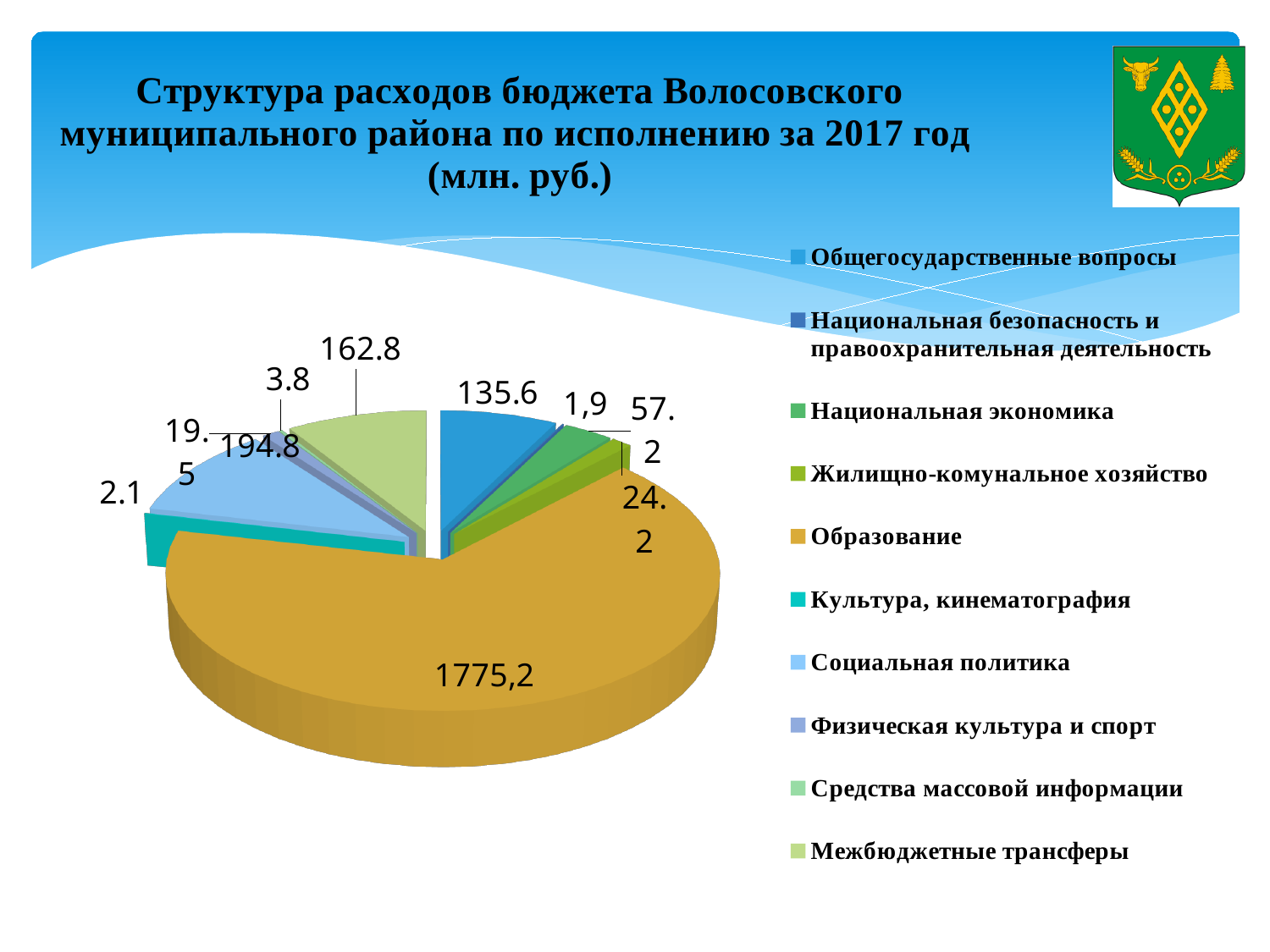
What is the value shown for Образование? 1775,2 What is the value shown for Национальная экономика? 57.2 Which is larger, the value for Социальная политика or the value for Межбюджетные трансферы? Социальная политика How many categories does the legend of the pie chart list? 10 What is the value shown for Общегосударственные вопросы? 135.6 What is the value shown for Социальная политика? 194.8 In what units are the values on the slide expressed, according to the title? млн. руб. Which category has the smallest value in the pie chart? Национальная безопасность и правоохранительная деятельность What is the value shown for Межбюджетные трансферы? 162.8 What is the difference between the values for Общегосударственные вопросы and Национальная экономика? 78.4 What kind of chart is shown on the slide? pie chart Which category has the largest slice of the pie chart? Образование